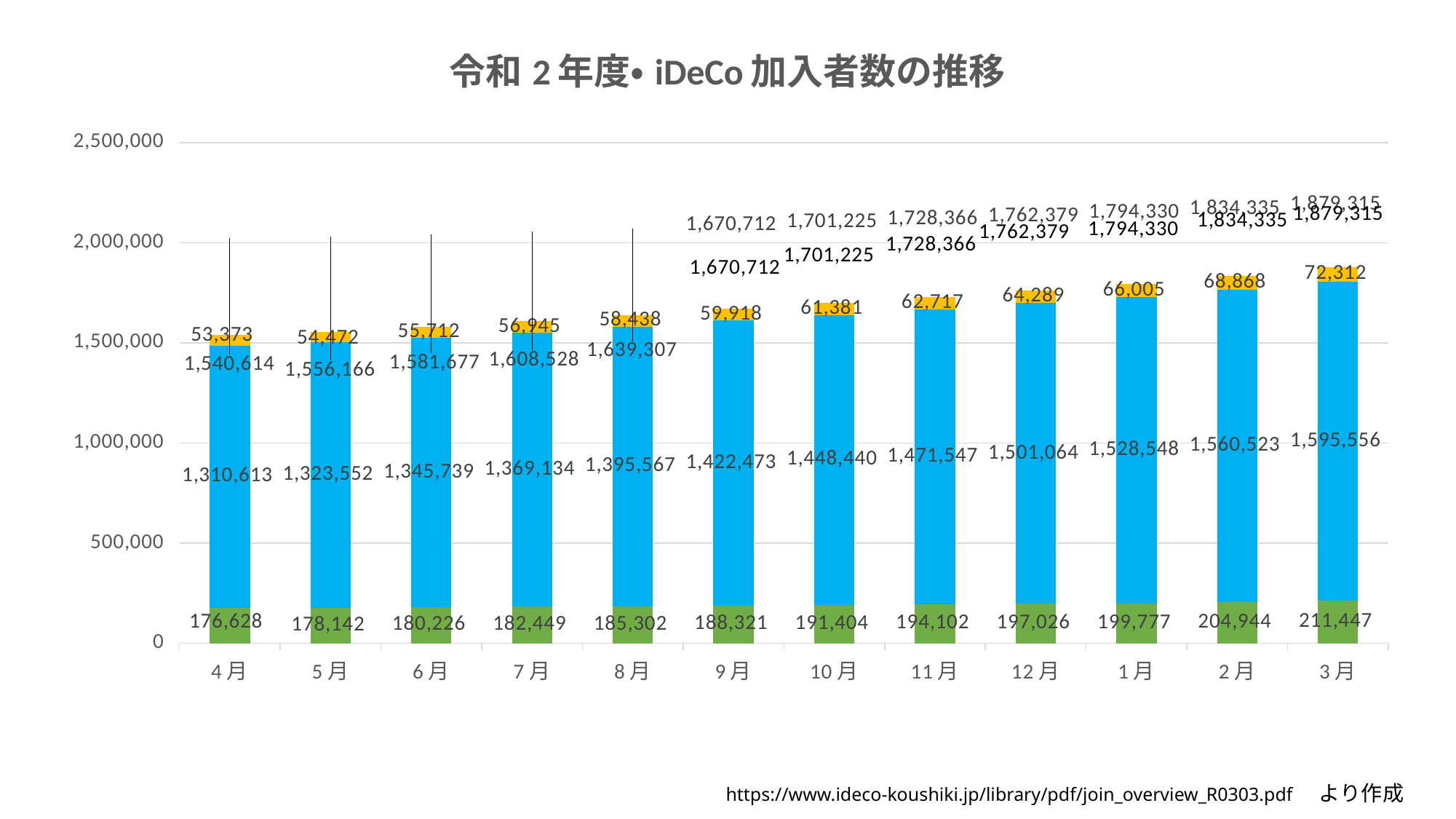
Which month has the lowest total? 4月 Which is larger, the green segment for 2月 or the green segment for 1月? 2月 What is the total value labelled above the bar for 3月? 1,879,315 What is the value of the green (bottom) segment for 10月? 191,404 What is the difference between the total for 3月 and the total for 4月? 338,701 What is the value of the orange (top) segment for 8月? 58,438 What is the value of the blue segment for 4月? 1,310,613 How many months are shown on the x axis? 12 Which month has the highest total? 3月 Is the total for 9月 greater or less than 1,500,000? greater Do the totals rise or fall from 4月 to 3月? Rise What kind of chart is this? Stacked bar chart